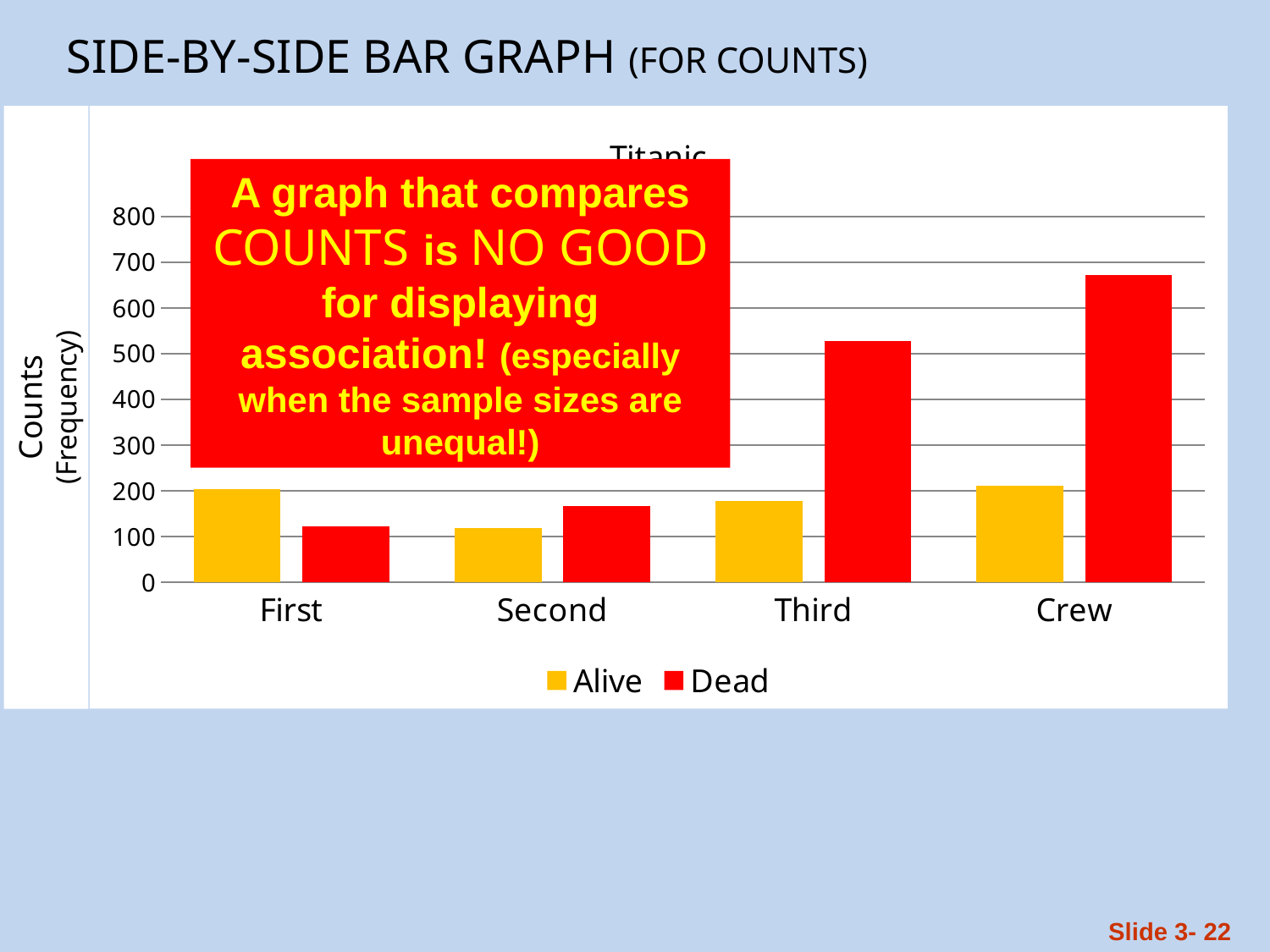
For the Third category, which is larger: the Alive count or the Dead count? Dead Which category has the highest Dead count? Crew For the First category, which is larger: the Alive count or the Dead count? Alive How many series does the chart's legend list? 2 Is the Alive value for Third greater or less than 200? less How many categories are shown on the x axis of the chart? 4 Is the Dead value for Crew greater or less than 600? greater What colour represents the Dead series in the chart? red Is the Dead value for Third greater or less than 500? greater Which category has the lowest Dead count? First Which category has the lowest Alive count? Second What kind of chart is shown on the slide? bar chart